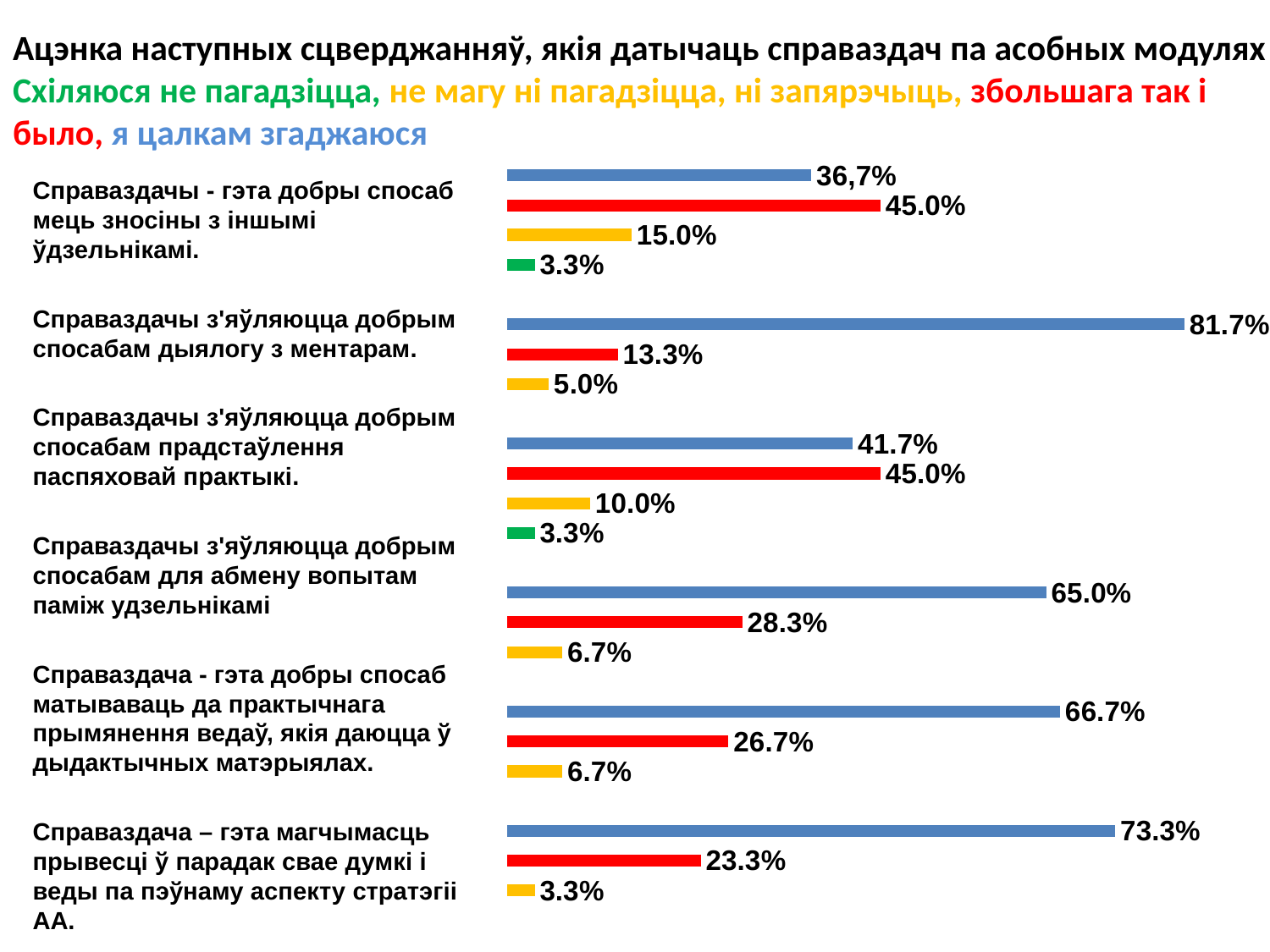
What is the value of the red bar (збольшага так і было) for the statement 'Справаздачы - гэта добры спосаб мець зносіны з іншымі ўдзельнікамі.'? 45.0% What is the value of the green bar (Схіляюся не пагадзіцца) for the statement 'Справаздачы - гэта добры спосаб мець зносіны з іншымі ўдзельнікамі.'? 3.3% What is the value of the blue bar (я цалкам згаджаюся) for the statement 'Справаздачы з'яўляюцца добрым спосабам дыялогу з ментарам.'? 81.7% Which statement has the lowest value for the blue series (я цалкам згаджаюся)? Справаздачы - гэта добры спосаб мець зносіны з іншымі ўдзельнікамі. What kind of chart is shown on the slide? bar chart Which colour represents the response 'я цалкам згаджаюся' in the chart? blue What is the value of the yellow bar (не магу ні пагадзіцца, ні запярэчыць) for the statement 'Справаздачы з'яўляюцца добрым спосабам прадстаўлення паспяховай практыкі.'? 10.0% Which statement has the highest value for the blue series (я цалкам згаджаюся)? Справаздачы з'яўляюцца добрым спосабам дыялогу з ментарам. What is the value of the blue bar (я цалкам згаджаюся) for the statement 'Справаздача – гэта магчымасць прывесці ў парадак свае думкі і веды па пэўнаму аспекту стратэгіі АА.'? 73.3% What is the difference between the blue bar (81.7%) and the red bar (13.3%) for the statement 'Справаздачы з'яўляюцца добрым спосабам дыялогу з ментарам.'? 68.4% How many statements (categories) are plotted in the chart? 6 For the statement 'Справаздачы з'яўляюцца добрым спосабам прадстаўлення паспяховай практыкі.', which is larger: the blue bar or the red bar? the red bar (45.0%)